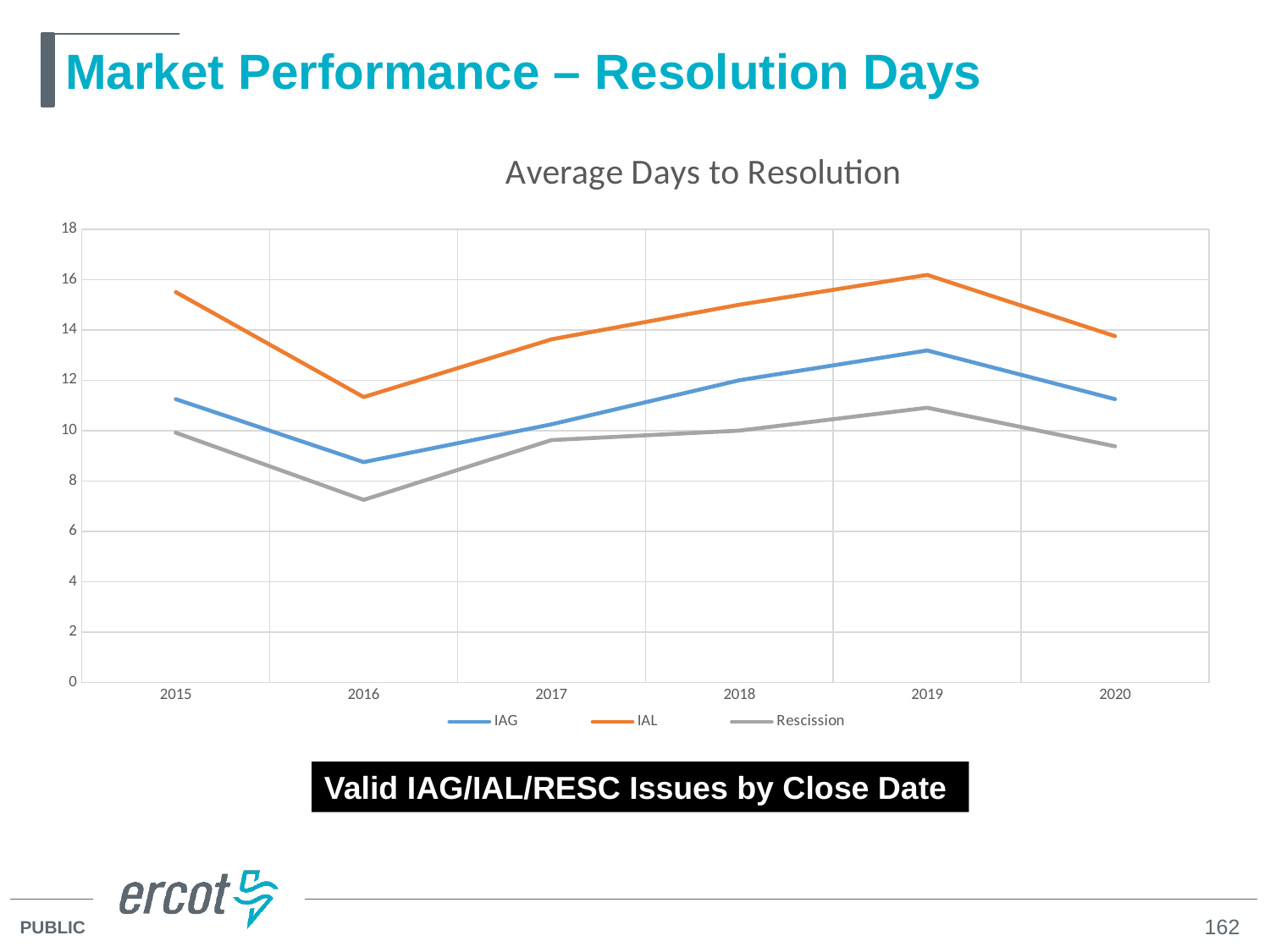
In which year does the IAL series reach its highest value? 2019 Is the IAL value for 2016 greater or less than 12? less What kind of chart is shown on the slide? line chart In which year does the Rescission series reach its lowest value? 2016 Do the IAL values rise or fall from 2016 to 2019? rise Is the IAG value for 2019 greater or less than 12? greater How many years are plotted along the x axis? 6 Which series is plotted in orange? IAL In which year does the IAG series reach its lowest value? 2016 How many series does the legend list? 3 Which series has the higher value in 2018, IAG or Rescission? IAG What is the title of the chart? Average Days to Resolution